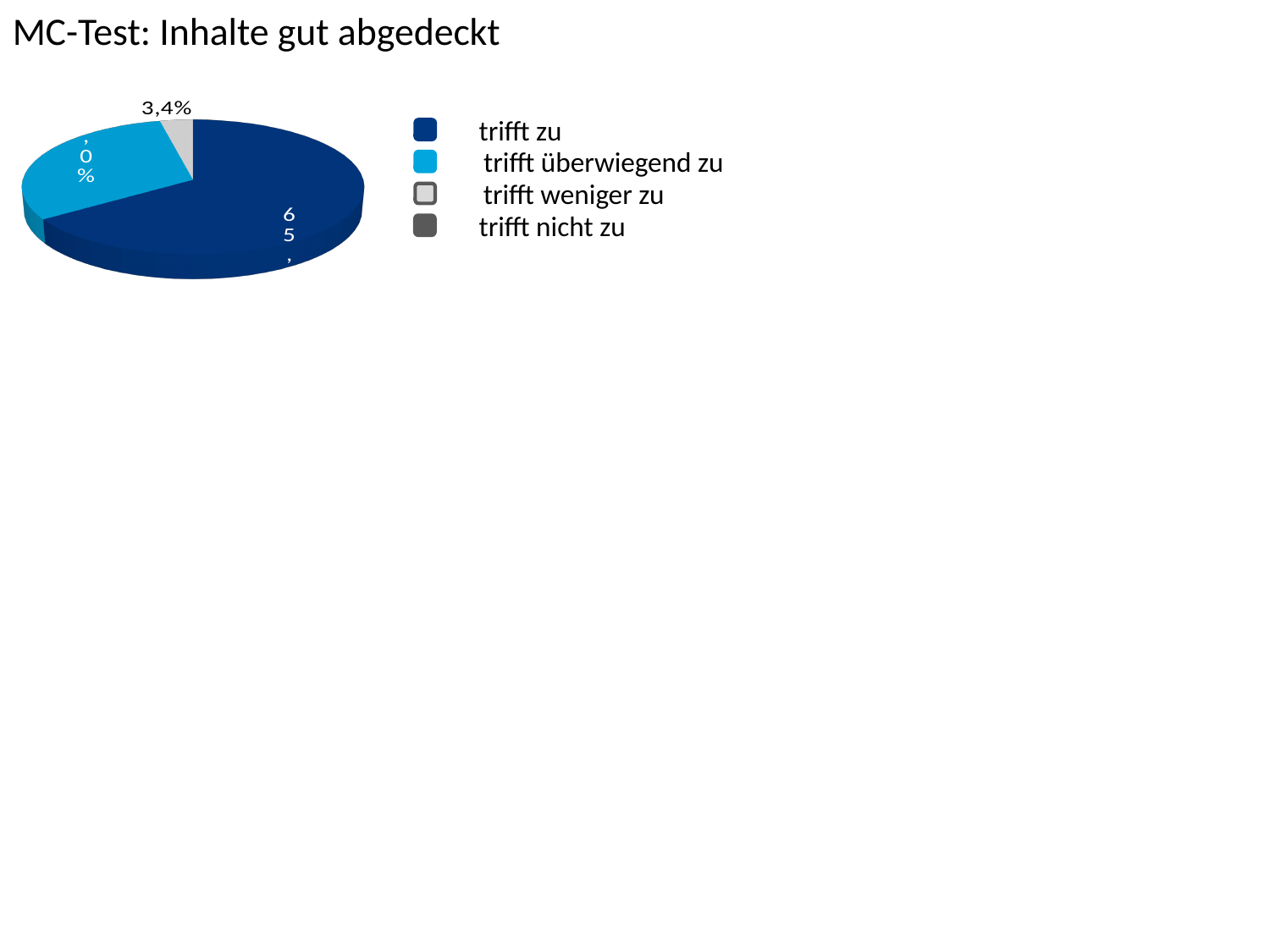
What kind of chart is shown on the slide? pie chart Which is larger, the slice for 'trifft überwiegend zu' or the slice for 'trifft weniger zu'? trifft überwiegend zu Is the share of the 'trifft zu' slice greater or less than 50%? greater Which category has the largest slice of the pie? trifft zu How many slices are visible in the pie chart? 3 Which is larger, the slice for 'trifft zu' or the slice for 'trifft überwiegend zu'? trifft zu What percentage is shown for the 'trifft weniger zu' slice? 3,4% Which legend entry is shown in dark blue? trifft zu How many entries does the legend of the pie chart list? 4 What is the title of the chart on the slide? MC-Test: Inhalte gut abgedeckt